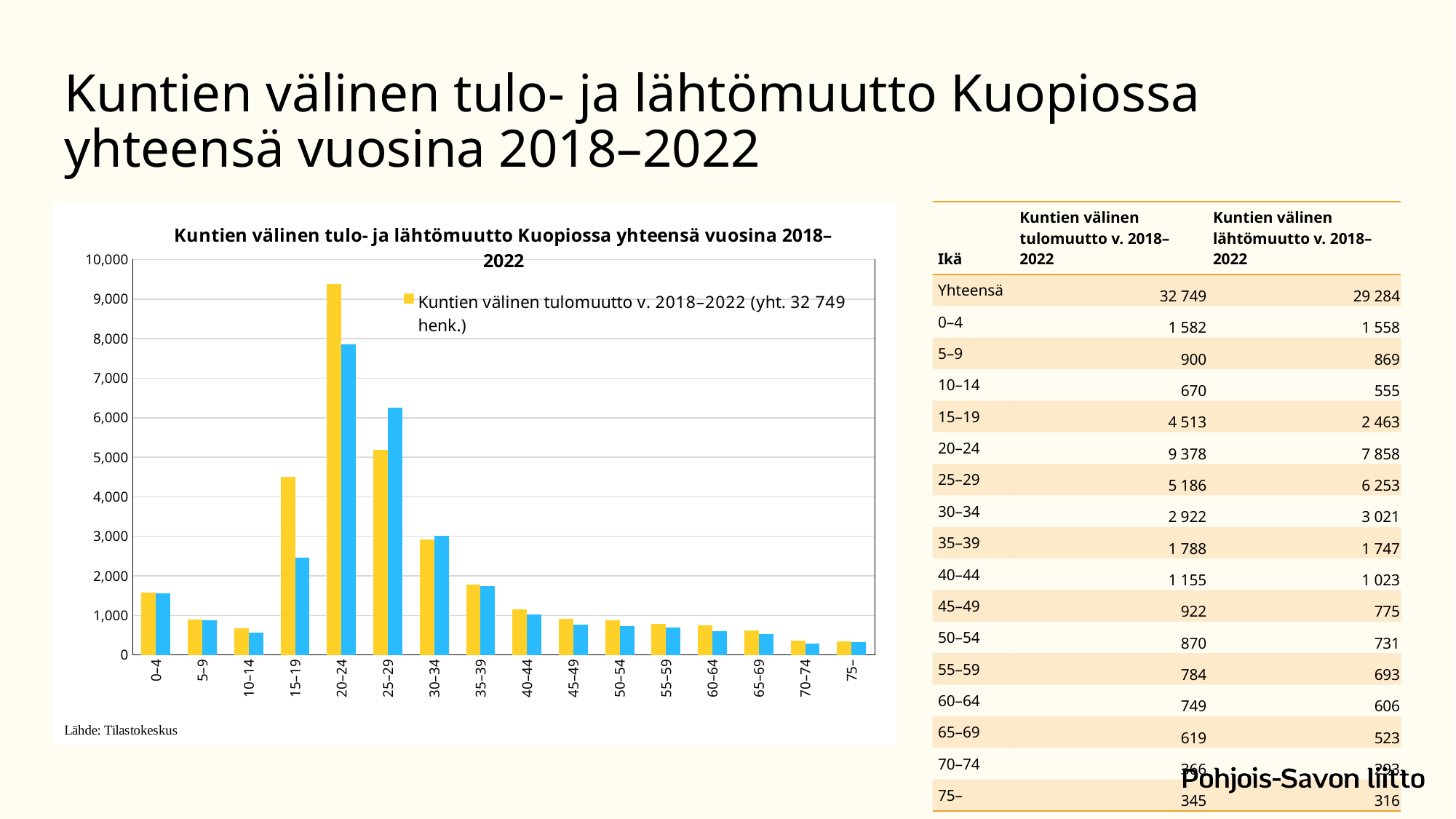
Which age group has the highest value for Kuntien välinen tulomuutto (yellow bars)? 20–24 For age group 25–29, which is larger: the yellow bar (tulomuutto) or the blue bar (lähtömuutto)? blue bar (lähtömuutto) According to the table, what is the Kuntien välinen tulomuutto value for age group 20–24? 9 378 According to the table, what is the difference between tulomuutto (9 378) and lähtömuutto (7 858) for age group 20–24? 1 520 Is the yellow bar (tulomuutto) for age group 30–34 greater or less than 3,000? less What type of chart is shown on the slide? bar chart For age group 15–19, which is larger: tulomuutto or lähtömuutto? tulomuutto Is the yellow bar (tulomuutto) for age group 15–19 greater or less than 4,000? greater How many age groups are shown on the x axis of the chart? 16 Which age group has the highest value for the blue bars (lähtömuutto)? 20–24 Is the blue bar (lähtömuutto) for age group 25–29 greater or less than 6,000? greater Do the bar values rise or fall along the x axis from age group 20–24 to 75–? fall